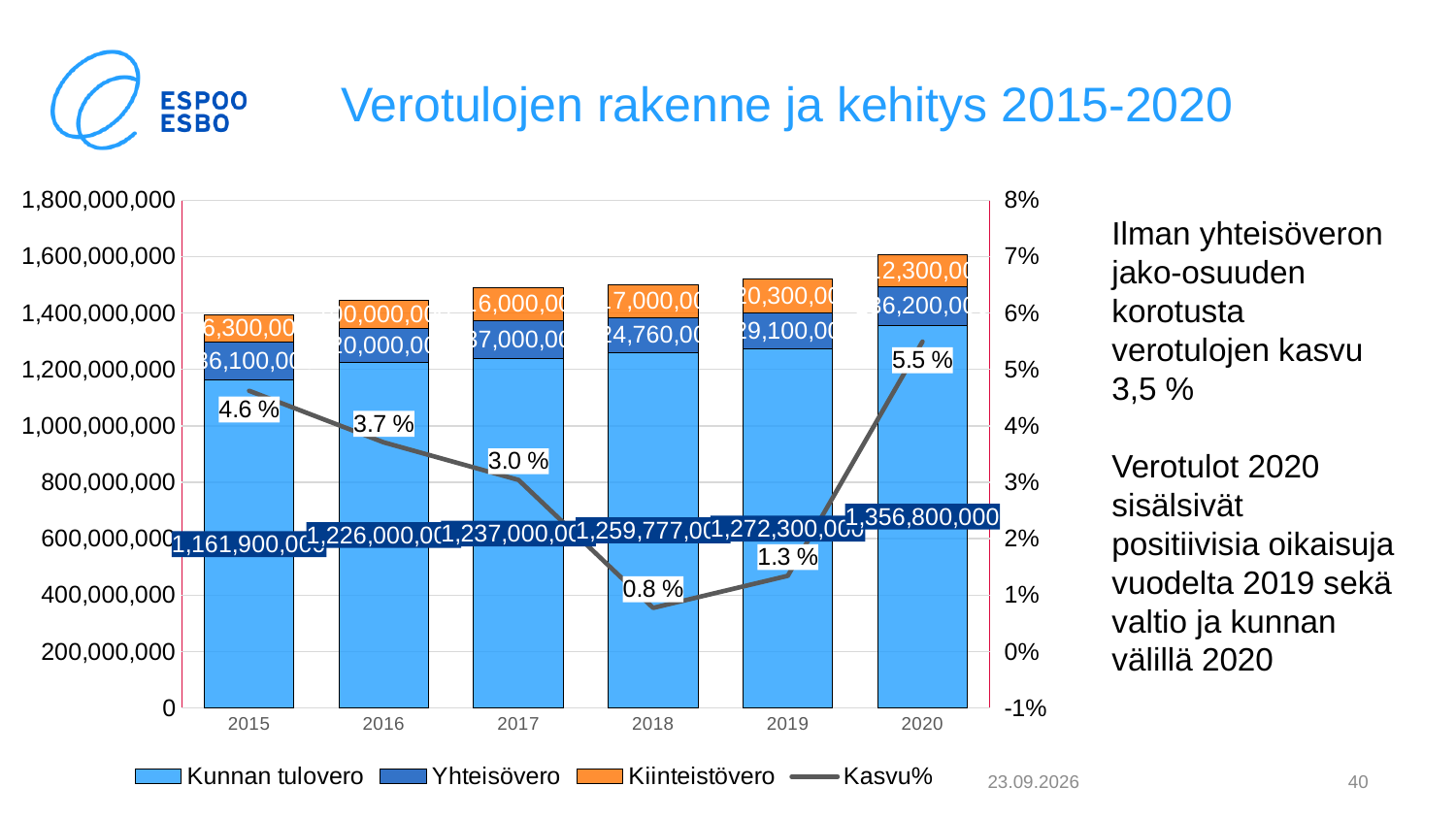
In which year is the Kasvu% lowest? 2018 How many series does the legend list? 4 What is the difference between the Kasvu% values for 2020 and 2018? 4.7 % Does the Kasvu% line rise or fall from 2015 to 2018? fall What is the Kasvu% value for 2015? 4.6 % How many years are shown on the x axis? 6 What is the Kunnan tulovero value for 2020? 1,356,800,000 In which year is the Kasvu% highest? 2020 Which year has the larger Kasvu% value, 2016 or 2019? 2016 Is the total height of the stacked bar for 2018 greater or less than 1,400,000,000? greater What is the Kasvu% value for 2020? 5.5 % What is the Kasvu% value for 2018? 0.8 %